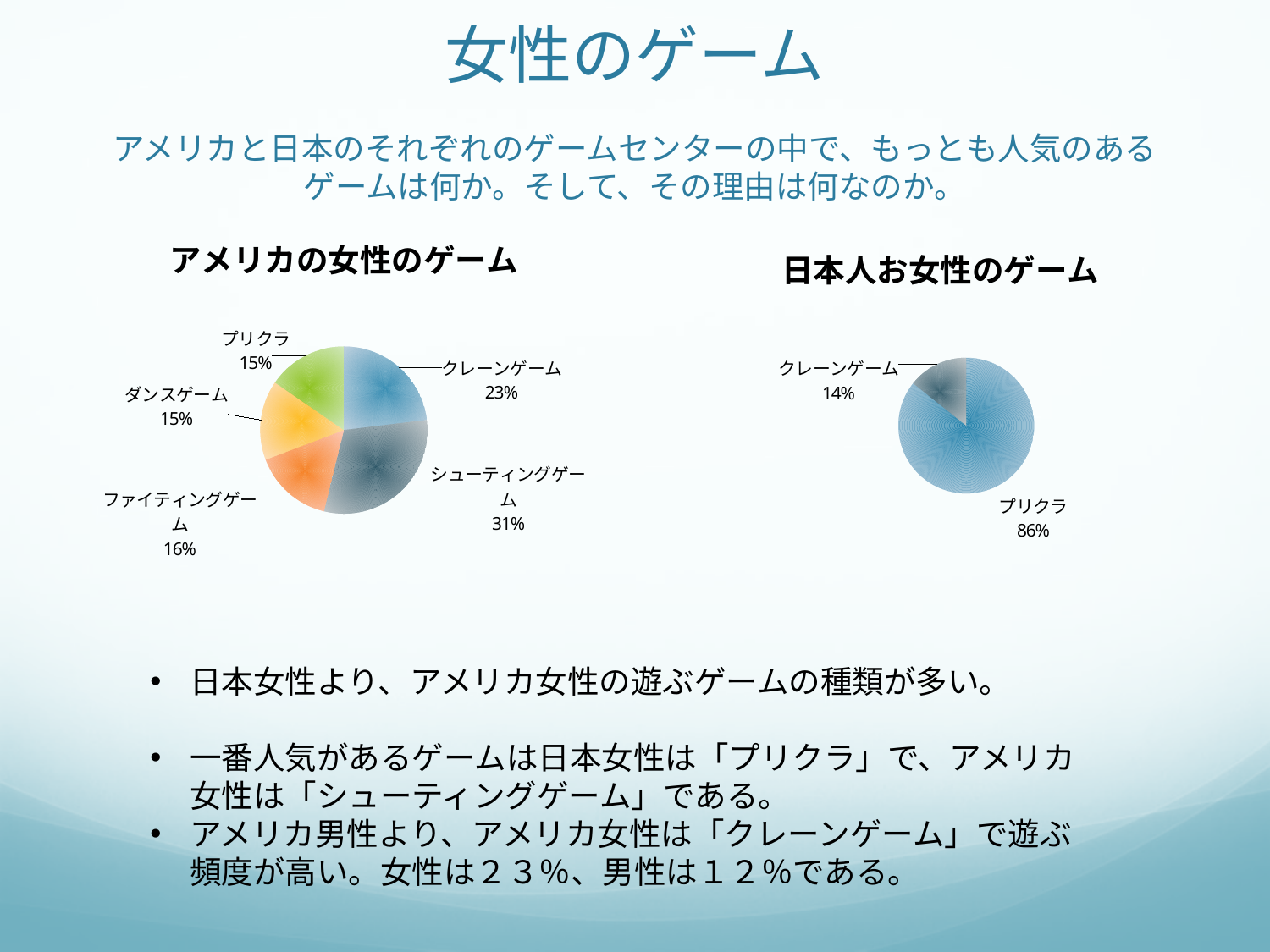
In the chart titled 日本人お女性のゲーム, what percentage is shown for プリクラ? 86% In the chart titled アメリカの女性のゲーム, which category has the largest slice? シューティングゲーム In the chart titled アメリカの女性のゲーム, which is larger, ファイティングゲーム or ダンスゲーム? ファイティングゲーム In the chart titled 日本人お女性のゲーム, what percentage is shown for クレーンゲーム? 14% In the chart titled アメリカの女性のゲーム, what percentage is shown for シューティングゲーム? 31% In the chart titled アメリカの女性のゲーム, what percentage is shown for クレーンゲーム? 23% What is the title of the chart on the left side of the slide? アメリカの女性のゲーム In the chart titled 日本人お女性のゲーム, which category has the smallest slice? クレーンゲーム In the chart titled 日本人お女性のゲーム, how many slices does the pie have? 2 In the chart titled アメリカの女性のゲーム, how many slices does the pie have? 5 In the chart titled アメリカの女性のゲーム, what is the difference between the シューティングゲーム and クレーンゲーム percentages? 8% What type of chart is the chart titled 日本人お女性のゲーム? Pie chart